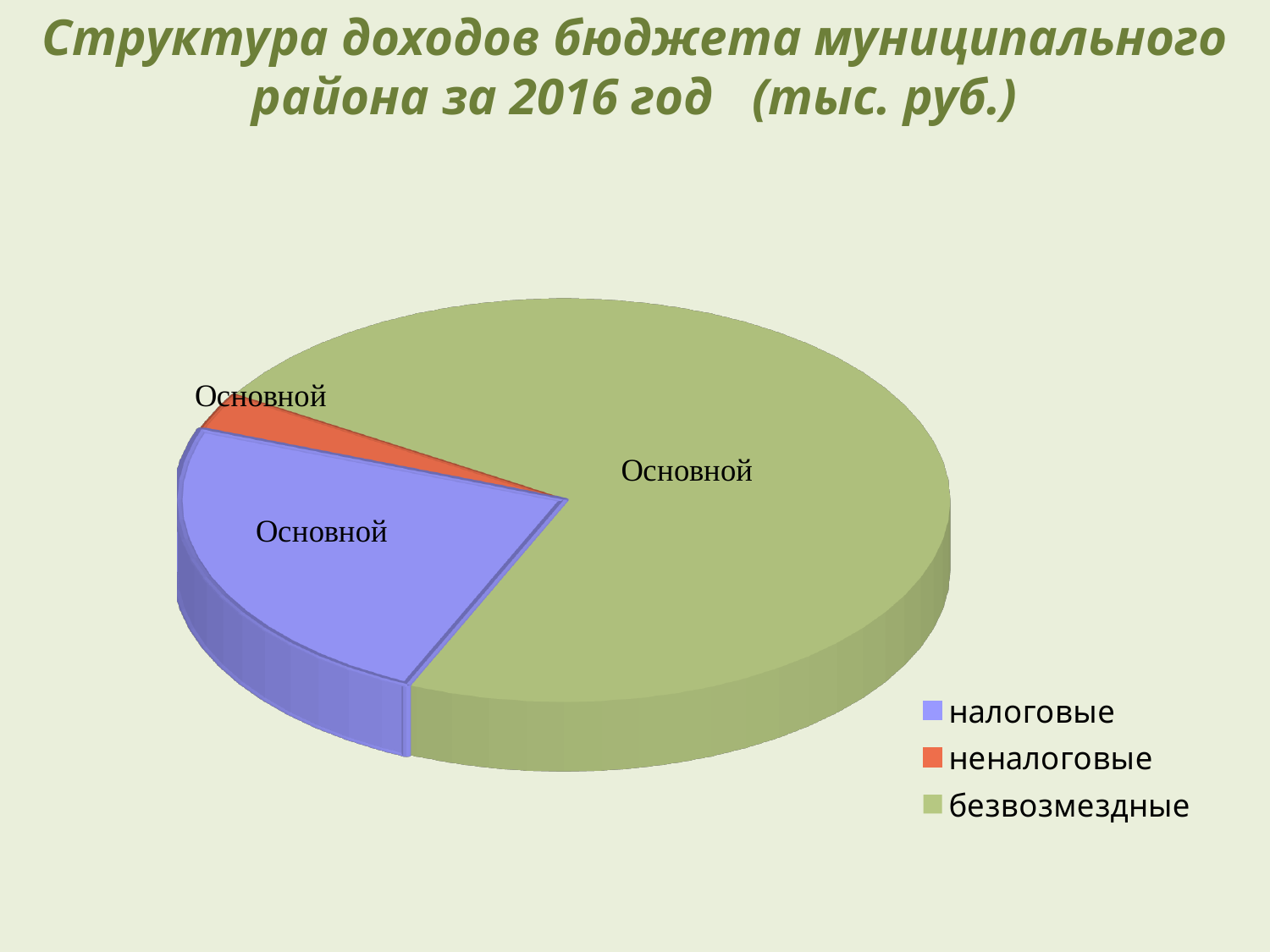
What colour is the slice for налоговые in the pie chart? blue Which category has the smallest slice of the pie chart? неналоговые Which slice is larger, безвозмездные or налоговые? безвозмездные How many slices does the pie chart have? 3 Which slice is smaller, неналоговые or безвозмездные? неналоговые What kind of chart is shown on the slide? pie chart Which category has the largest slice of the pie chart? безвозмездные What is the title of the chart on the slide? Структура доходов бюджета муниципального района за 2016 год (тыс. руб.) Which year does the chart title refer to? 2016 Which slice is larger, налоговые or неналоговые? налоговые How many entries does the legend of the pie chart list? 3